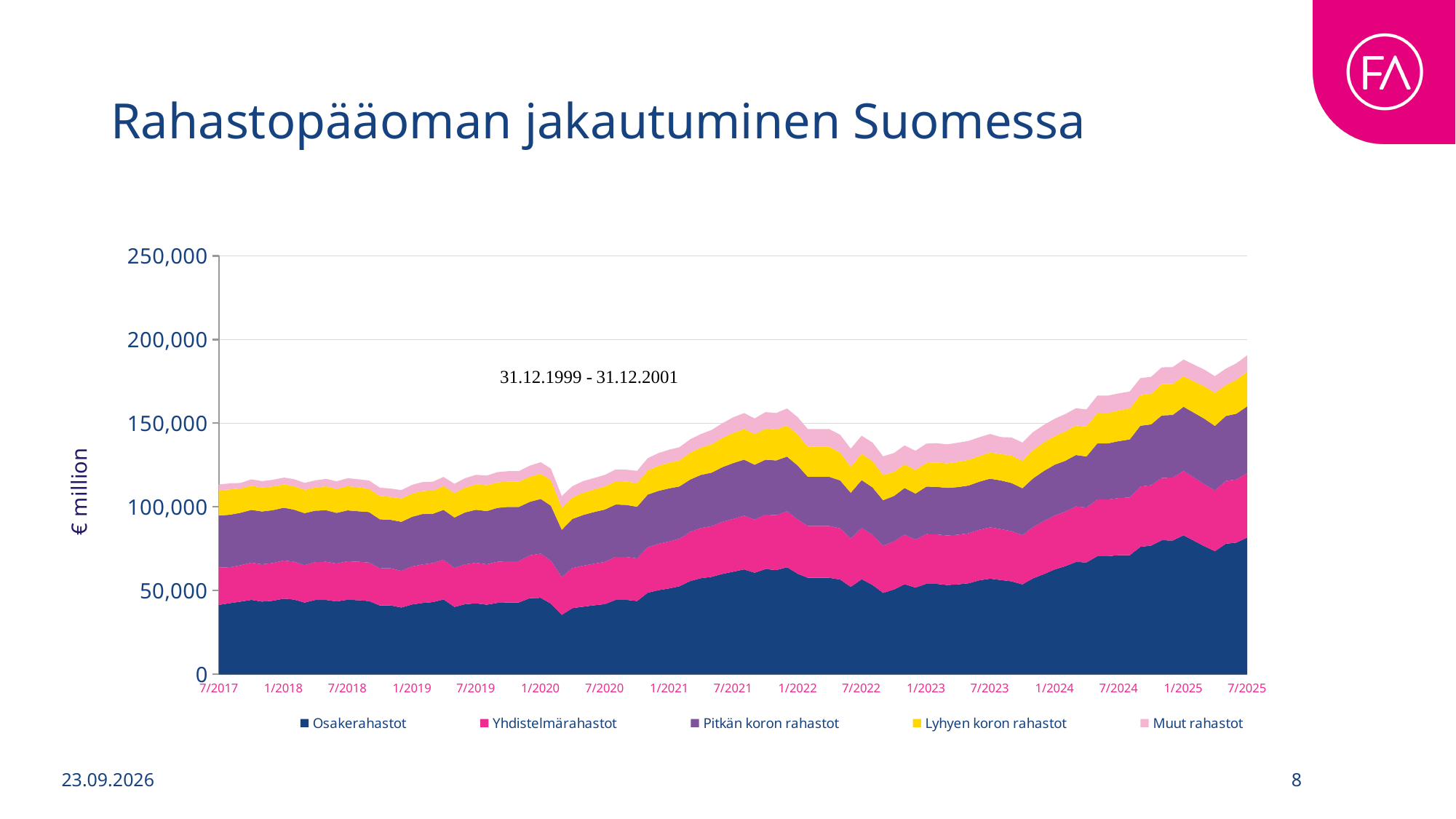
What is the label on the vertical axis? € million What is the title of the chart? Rahastopääoman jakautuminen Suomessa Which series has the largest value at 7/2025? Osakerahastot Is the value for Osakerahastot larger at 7/2017 or at 7/2025? 7/2025 Is the value for Osakerahastot at 7/2025 greater or less than 50,000? greater Which series has the smallest value at 7/2025? Muut rahastot Is the total value at 7/2017 greater or less than 150,000? less How many series does the legend list? 5 Is the value for Osakerahastot at 7/2017 greater or less than 50,000? less Does the total fund capital rise or fall overall from 7/2017 to 7/2025? Rise What kind of chart is shown on the slide? Stacked area chart